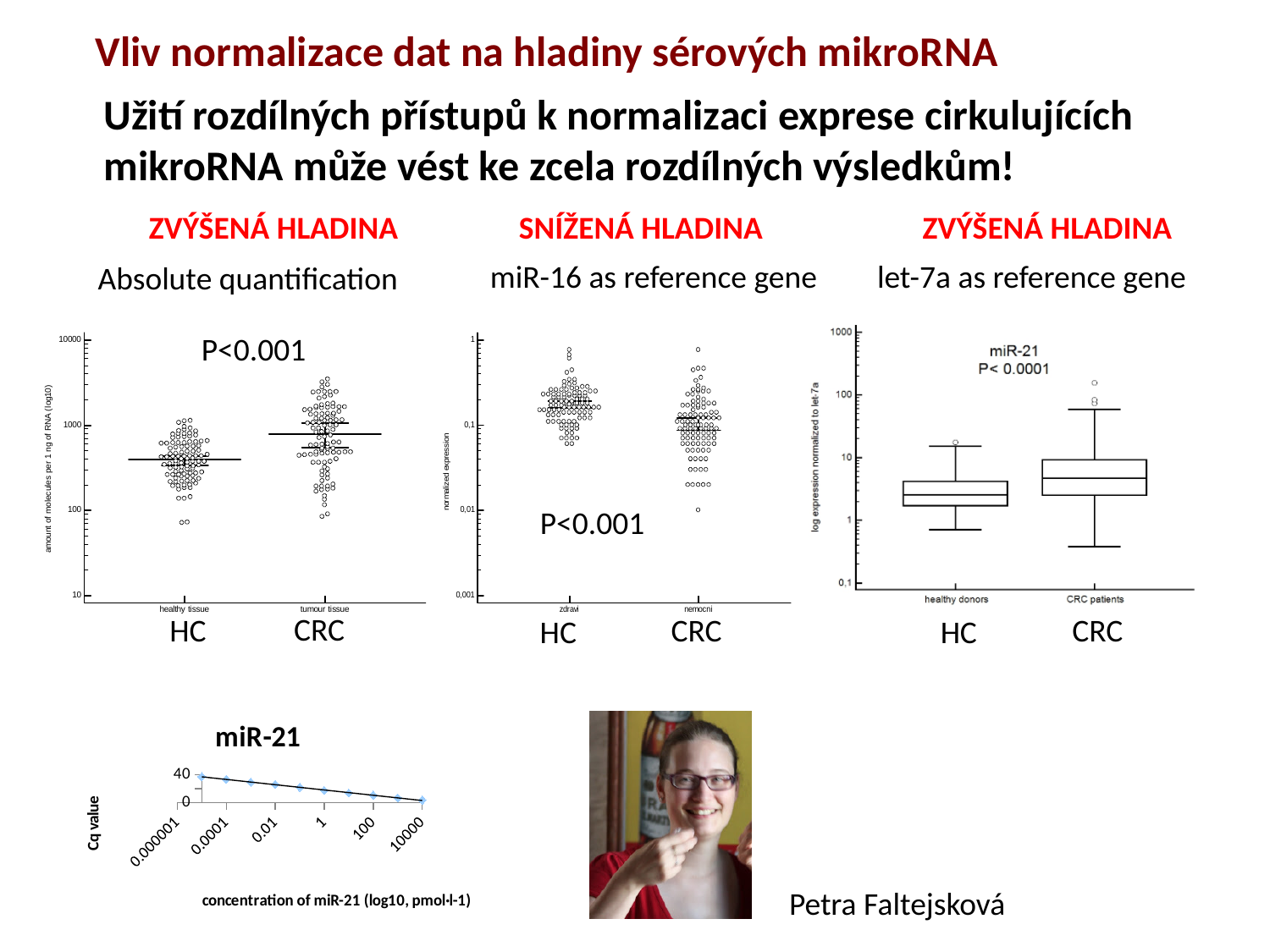
In the miR-16 as reference gene chart, which group has the higher median normalized expression, HC or CRC? HC In the miR-16 as reference gene chart, is the median value for CRC greater or less than 1? less What is the y-axis label of the miR-21 chart at the bottom left? Cq value In the let-7a as reference gene chart, which group has the higher median, HC or CRC? CRC What kind of chart is the miR-21 chart at the bottom left of the slide? line chart In the Absolute quantification chart, is the median value for HC greater or less than 1000? less What P value is printed on the let-7a as reference gene chart? P< 0.0001 In the miR-21 chart at the bottom left, does the Cq value rise or fall as the concentration of miR-21 increases along the x axis? fall In the Absolute quantification chart, is the median value for HC greater or less than 100? greater In the Absolute quantification chart, which group has the higher median level, HC or CRC? CRC How many groups are shown on the x axis of the let-7a as reference gene chart? 2